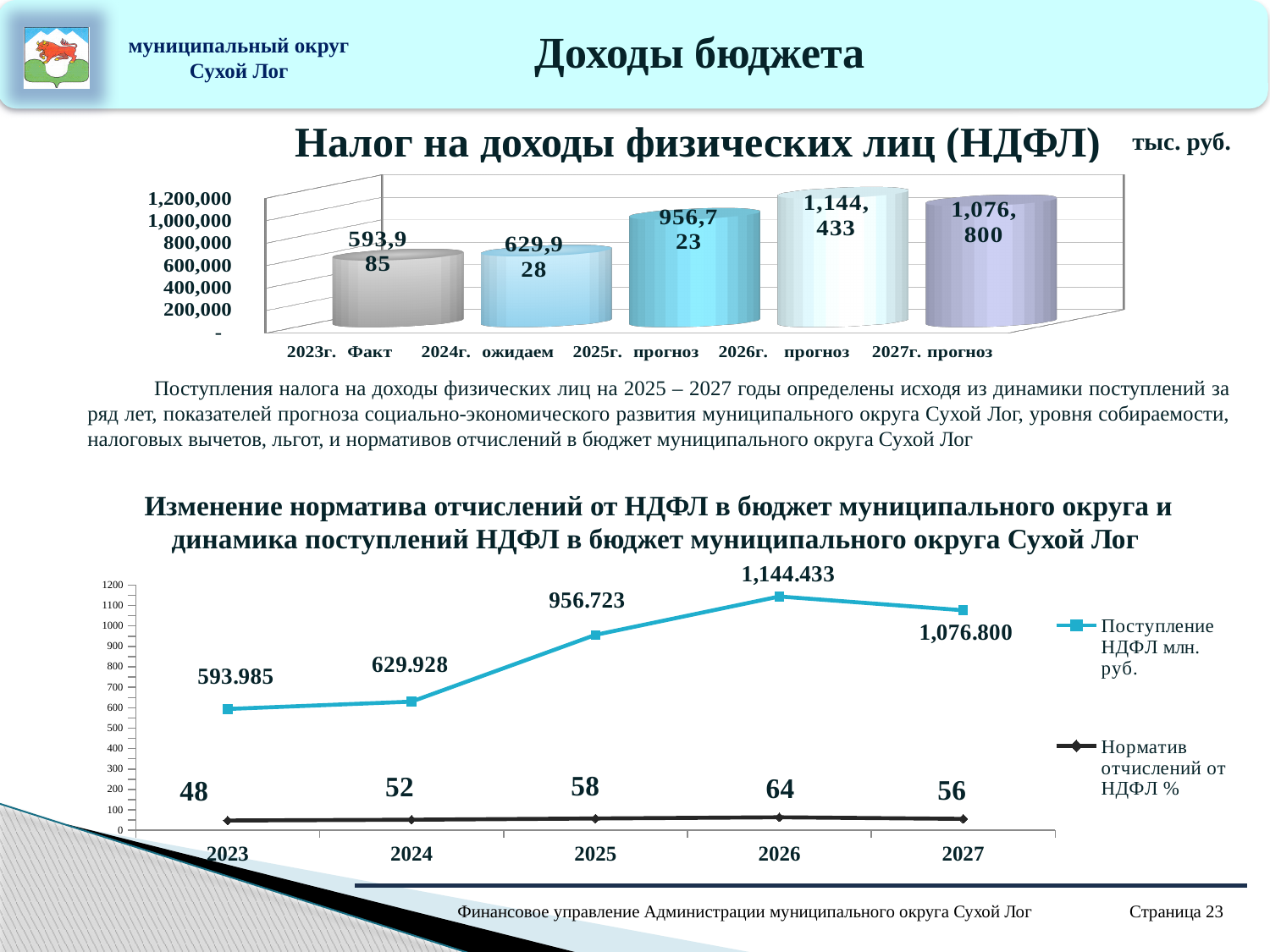
What type of chart is the top chart 'Налог на доходы физических лиц (НДФЛ)'? Bar chart In the bottom line chart, what is the value of 'Норматив отчислений от НДФЛ %' for 2026? 64 In the top chart 'Налог на доходы физических лиц (НДФЛ)', what unit is indicated next to the title? тыс. руб. In the top chart 'Налог на доходы физических лиц (НДФЛ)', which year has the lowest value? 2023г. Факт In the top chart 'Налог на доходы физических лиц (НДФЛ)', what is the value for 2023г. Факт? 593,985 In the top chart 'Налог на доходы физических лиц (НДФЛ)', how many bars are shown? 5 In the bottom line chart, is the 'Норматив отчислений от НДФЛ %' value for 2027 larger or smaller than the value for 2026? Smaller In the bottom line chart, how many series does the legend list? 2 In the bottom line chart, what is the value of 'Поступление НДФЛ млн. руб.' for 2024? 629.928 In the top chart 'Налог на доходы физических лиц (НДФЛ)', what is the value for 2025г. прогноз? 956,723 In the bottom line chart, what is the difference between the 'Норматив отчислений от НДФЛ %' values for 2026 and 2023? 16 In the top chart 'Налог на доходы физических лиц (НДФЛ)', which year has the highest value? 2026г. прогноз